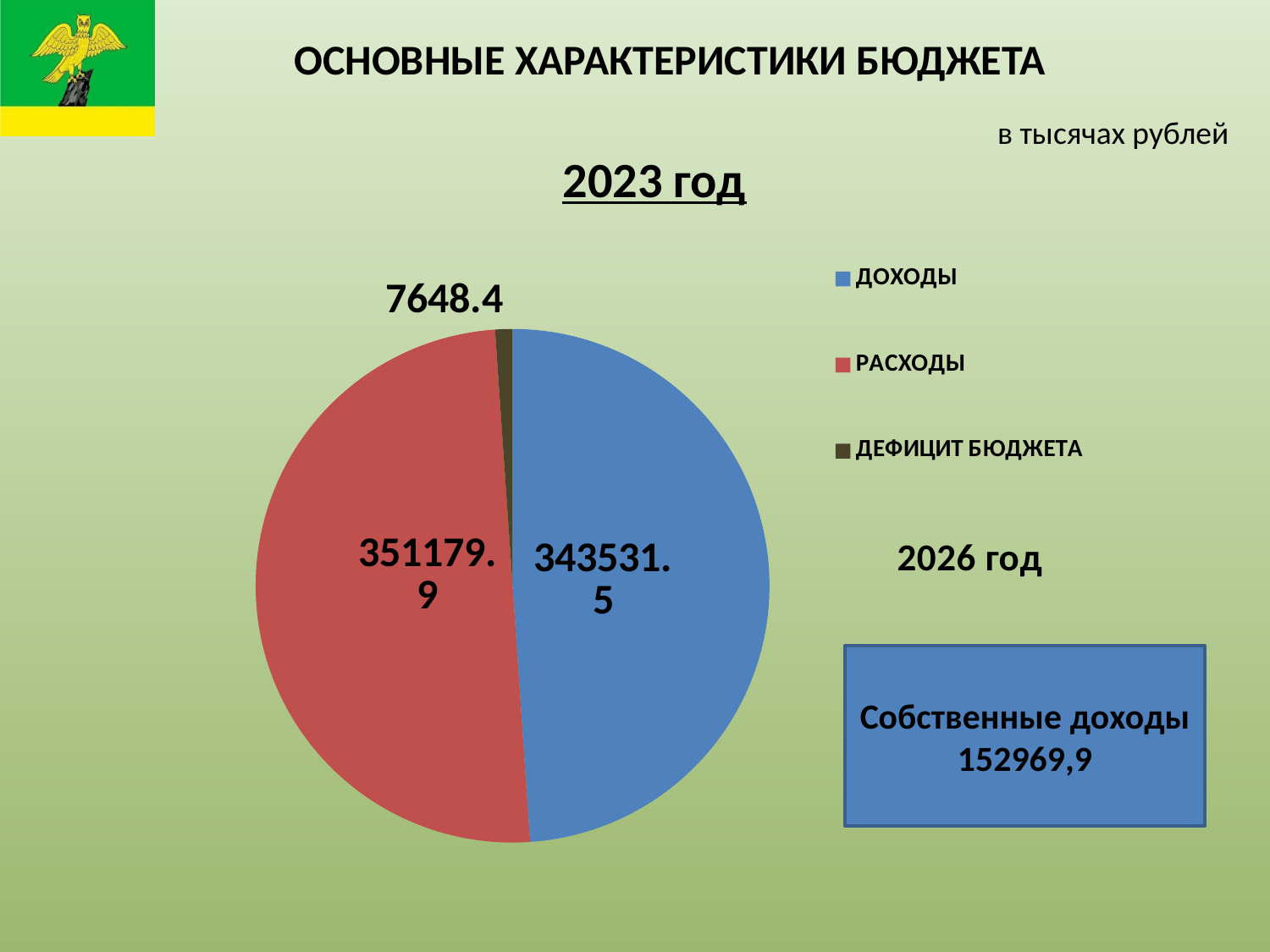
What is the value for РАСХОДЫ in the pie chart? 351179.9 Which category has the smallest slice in the pie chart? ДЕФИЦИТ БЮДЖЕТА What is the value for ДОХОДЫ in the pie chart? 343531.5 What is the difference between the values for РАСХОДЫ and ДОХОДЫ? 7648.4 How many slices does the pie chart have? 3 What is the value for ДЕФИЦИТ БЮДЖЕТА in the pie chart? 7648.4 Which category has the largest slice in the pie chart? РАСХОДЫ What year is shown as the title above the pie chart? 2023 год How many entries does the legend of the pie chart list? 3 What type of chart is shown on the slide? pie chart Which is larger, the value for ДОХОДЫ or the value for РАСХОДЫ? РАСХОДЫ What colour is the ДОХОДЫ slice in the pie chart? blue